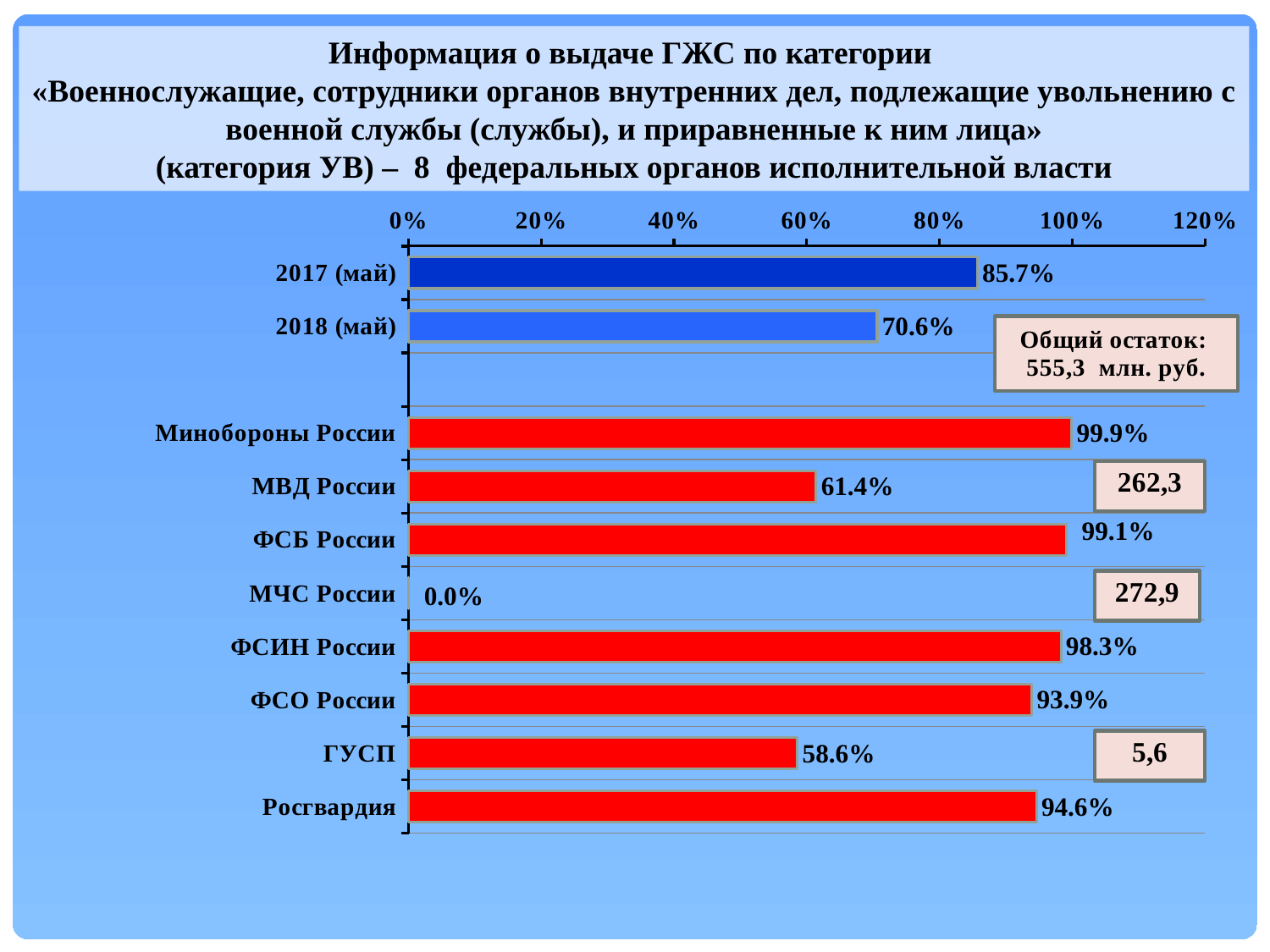
What kind of chart is shown on the slide? bar chart Which of the eight federal agencies has the highest value? Минобороны России What is the value shown for Минобороны России? 99.9% Is the value for МВД России greater or less than 80%? less What is the value shown for ГУСП? 58.6% What colour are the bars for the federal agencies (Минобороны России through Росгвардия)? red Which category has the lowest value on the chart? МЧС России What is the difference between the values for 2017 (май) and 2018 (май)? 15.1% How many categories are plotted on the chart? 10 Which is larger, the value for ФСО России or the value for Росгвардия? Росгвардия What is the value shown for МЧС России? 0.0% What is the value shown for 2018 (май)? 70.6%